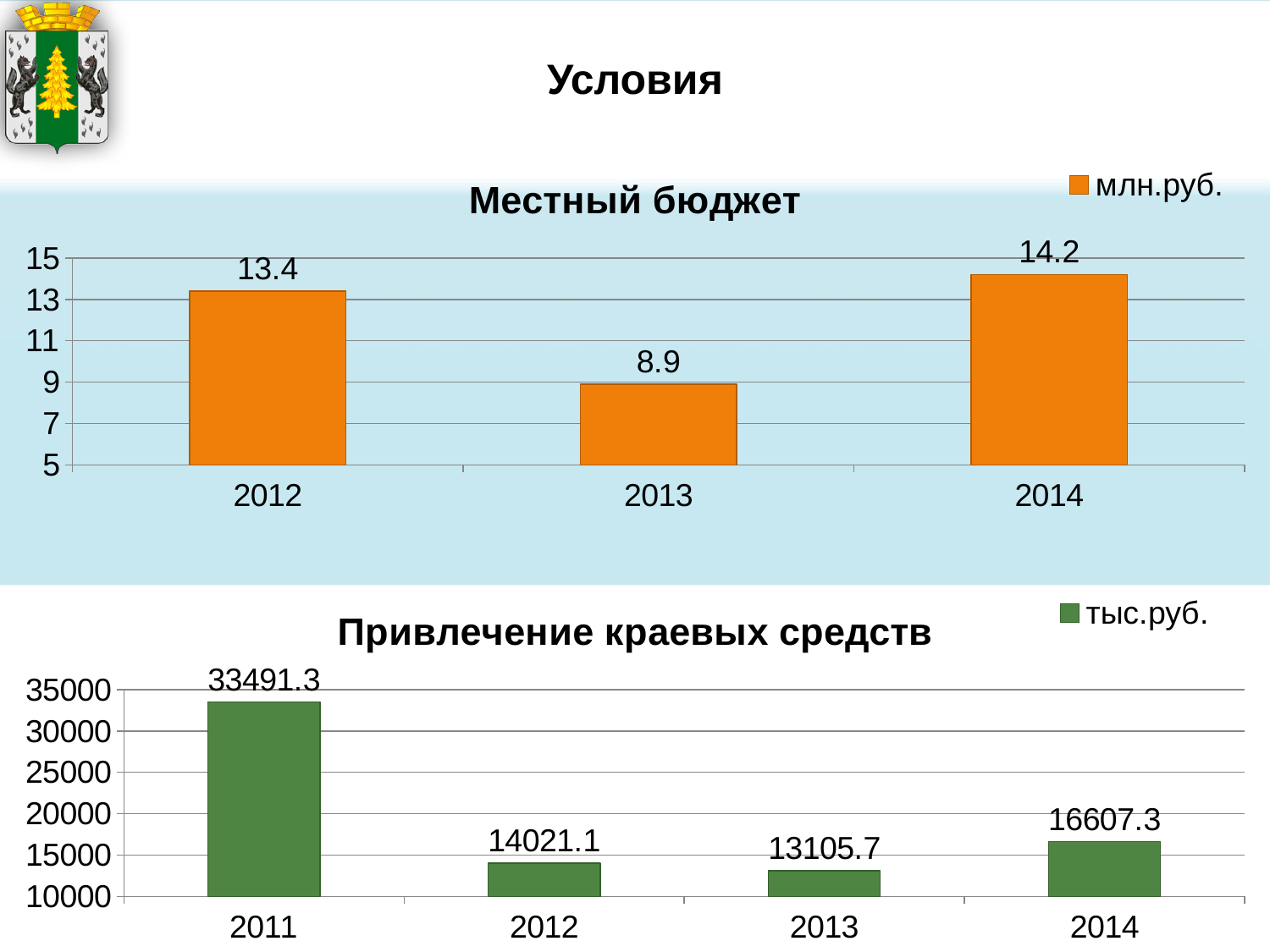
In the 'Привлечение краевых средств' chart, what is the difference between the 2012 and 2013 values? 915.4 In the 'Привлечение краевых средств' chart, what is the value for 2011? 33491.3 In the 'Местный бюджет' chart, what is the difference between the 2014 and 2012 values? 0.8 In the 'Привлечение краевых средств' chart, is the value for 2014 greater or less than 15000? greater In the 'Местный бюджет' chart, what is the value for 2013? 8.9 In the 'Привлечение краевых средств' chart, which year has the lowest value? 2013 What type of chart is the 'Привлечение краевых средств' chart? Bar chart In the 'Местный бюджет' chart, how many years are shown? 3 In the 'Привлечение краевых средств' chart, how many years are shown? 4 In the 'Местный бюджет' chart, which year has the highest value? 2014 In the 'Местный бюджет' chart, what unit does the legend show? млн.руб. In the 'Привлечение краевых средств' chart, which is larger, the value for 2012 or 2014? 2014